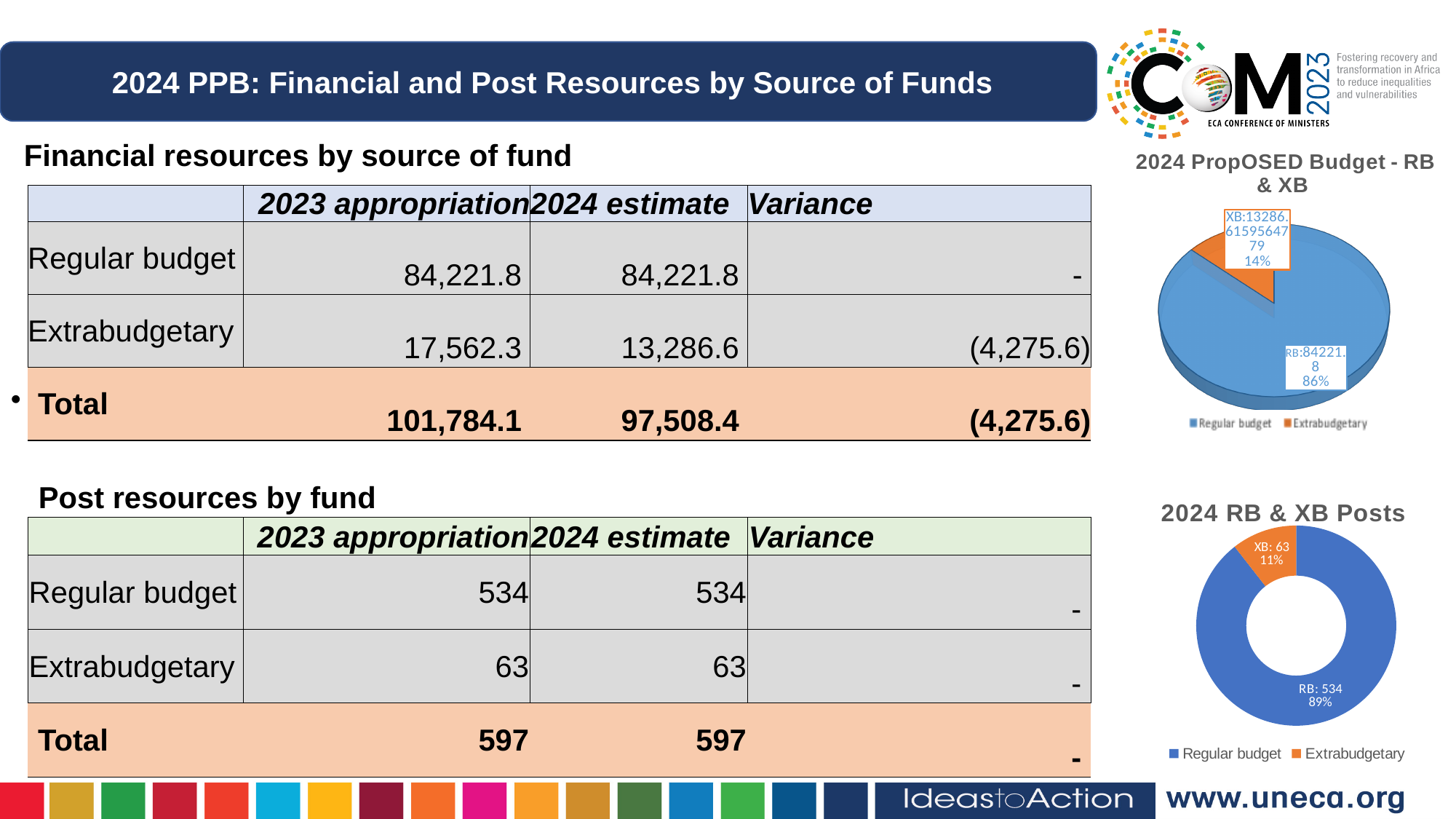
In the '2024 RB & XB Posts' chart, what share does Extrabudgetary (XB) represent? 11% In the '2024 PropOSED Budget - RB & XB' chart, what share of the pie does Extrabudgetary (XB) represent? 14% In the '2024 PropOSED Budget - RB & XB' chart, what share of the pie does Regular budget (RB) represent? 86% In the '2024 PropOSED Budget - RB & XB' chart, which slice is the largest? Regular budget In the '2024 RB & XB Posts' chart, what colour is the Extrabudgetary slice? Orange In the '2024 RB & XB Posts' chart, what value is labelled for RB? 534 What kind of chart is '2024 PropOSED Budget - RB & XB'? Pie chart In the '2024 RB & XB Posts' chart, what is the difference between the RB and XB values? 471 In the '2024 RB & XB Posts' chart, which slice is the smallest? Extrabudgetary How many entries does the legend of the '2024 PropOSED Budget - RB & XB' chart list? 2 In the '2024 PropOSED Budget - RB & XB' chart, what value is labelled for RB? 84221.8 In the '2024 RB & XB Posts' chart, what value is labelled for XB? 63